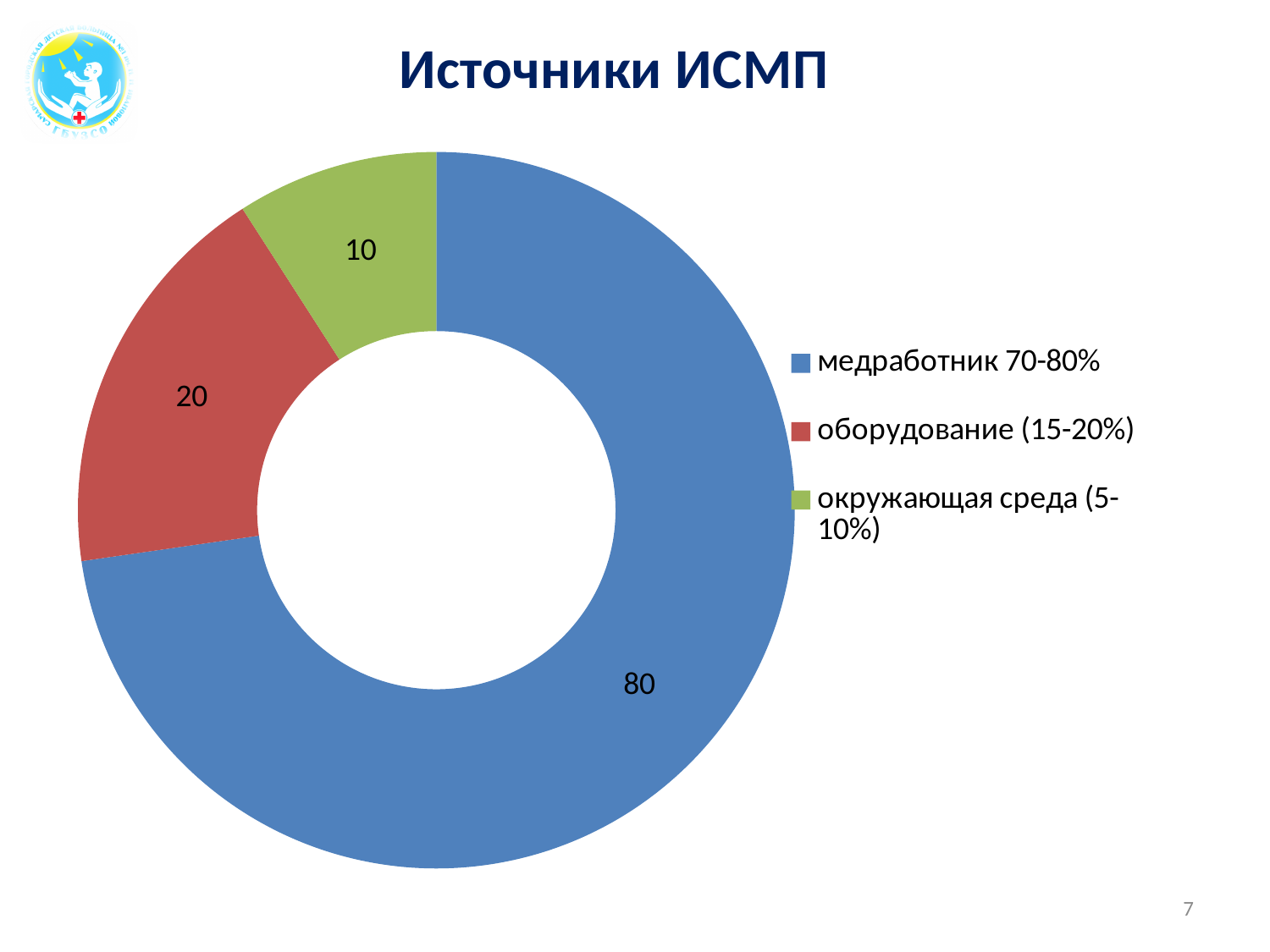
What is the value for оборудование (15-20%)? 20 What type of chart is shown on the slide? Doughnut (pie) chart What colour is the slice for окружающая среда (5-10%)? Green Which is larger, the value for оборудование (15-20%) or окружающая среда (5-10%)? оборудование (15-20%) What is the title of the slide? Источники ИСМП What is the value for медработник 70-80%? 80 Which category has the largest slice? медработник 70-80% What is the difference between the values for медработник 70-80% and оборудование (15-20%)? 60 Which category has the smallest slice? окружающая среда (5-10%) How many categories does the chart show? 3 What is the value for окружающая среда (5-10%)? 10